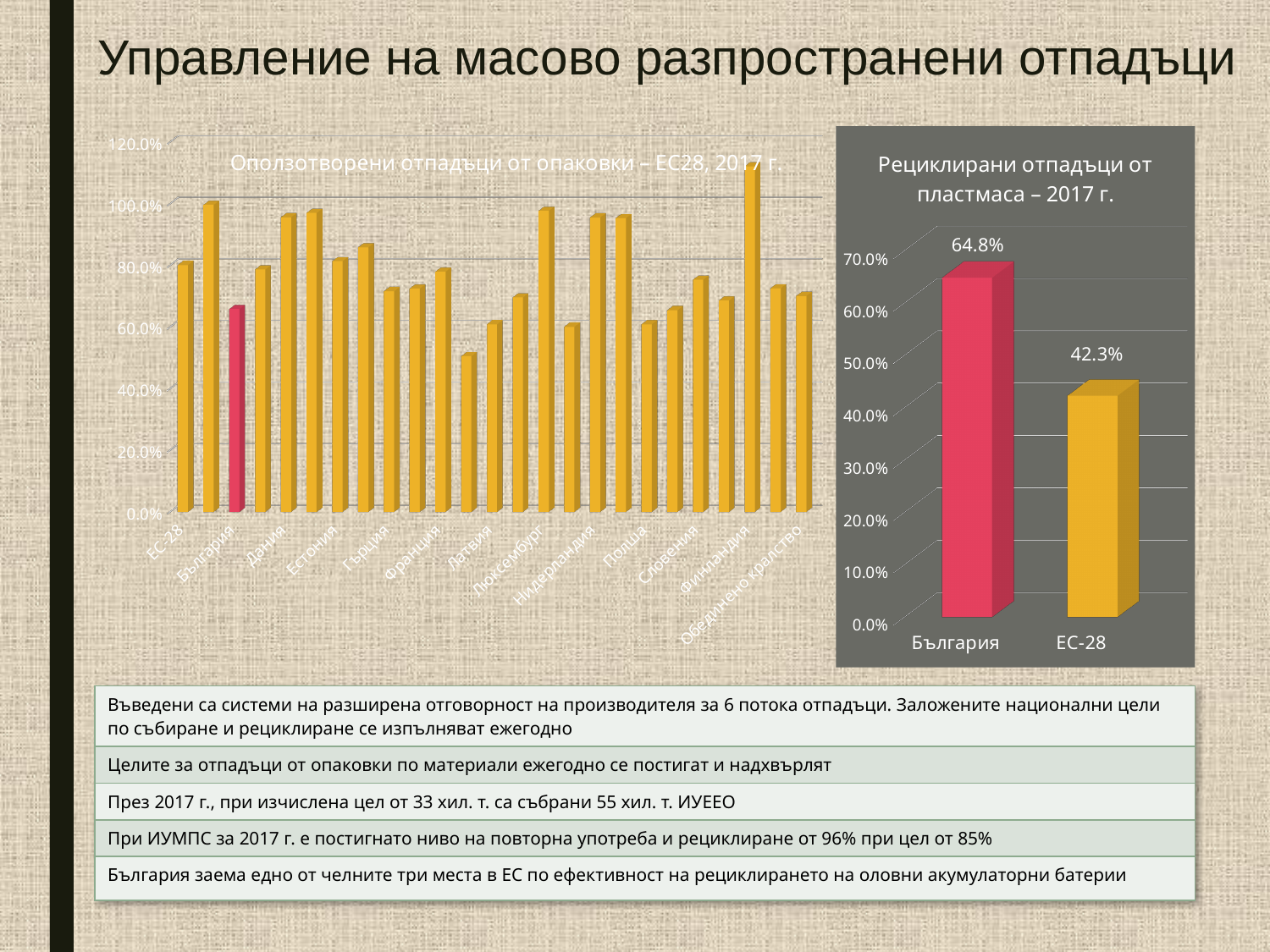
In the chart titled "Рециклирани отпадъци от пластмаса – 2017 г.", how many categories are shown? 2 In the chart on the left, which of ЕС-28 and България has the larger value? ЕС-28 In the chart on the left, is the value for ЕС-28 greater or less than 60.0%? greater In the chart on the left, is the value for България greater or less than 60.0%? greater In the chart titled "Рециклирани отпадъци от пластмаса – 2017 г.", which category has the higher value? България What kind of chart is the one titled "Рециклирани отпадъци от пластмаса – 2017 г."? Bar chart In the chart titled "Рециклирани отпадъци от пластмаса – 2017 г.", what is the difference between the values for България and ЕС-28? 22.5% In the chart titled "Рециклирани отпадъци от пластмаса – 2017 г.", which category has the lowest value? ЕС-28 What is the title of the chart on the left? Оползотворени отпадъци от опаковки – ЕС28, 2017 г. In the chart titled "Рециклирани отпадъци от пластмаса – 2017 г.", is the value for ЕС-28 greater or less than 50.0%? less In the chart titled "Рециклирани отпадъци от пластмаса – 2017 г.", what is the value for ЕС-28? 42.3% In the chart titled "Рециклирани отпадъци от пластмаса – 2017 г.", what is the value for България? 64.8%